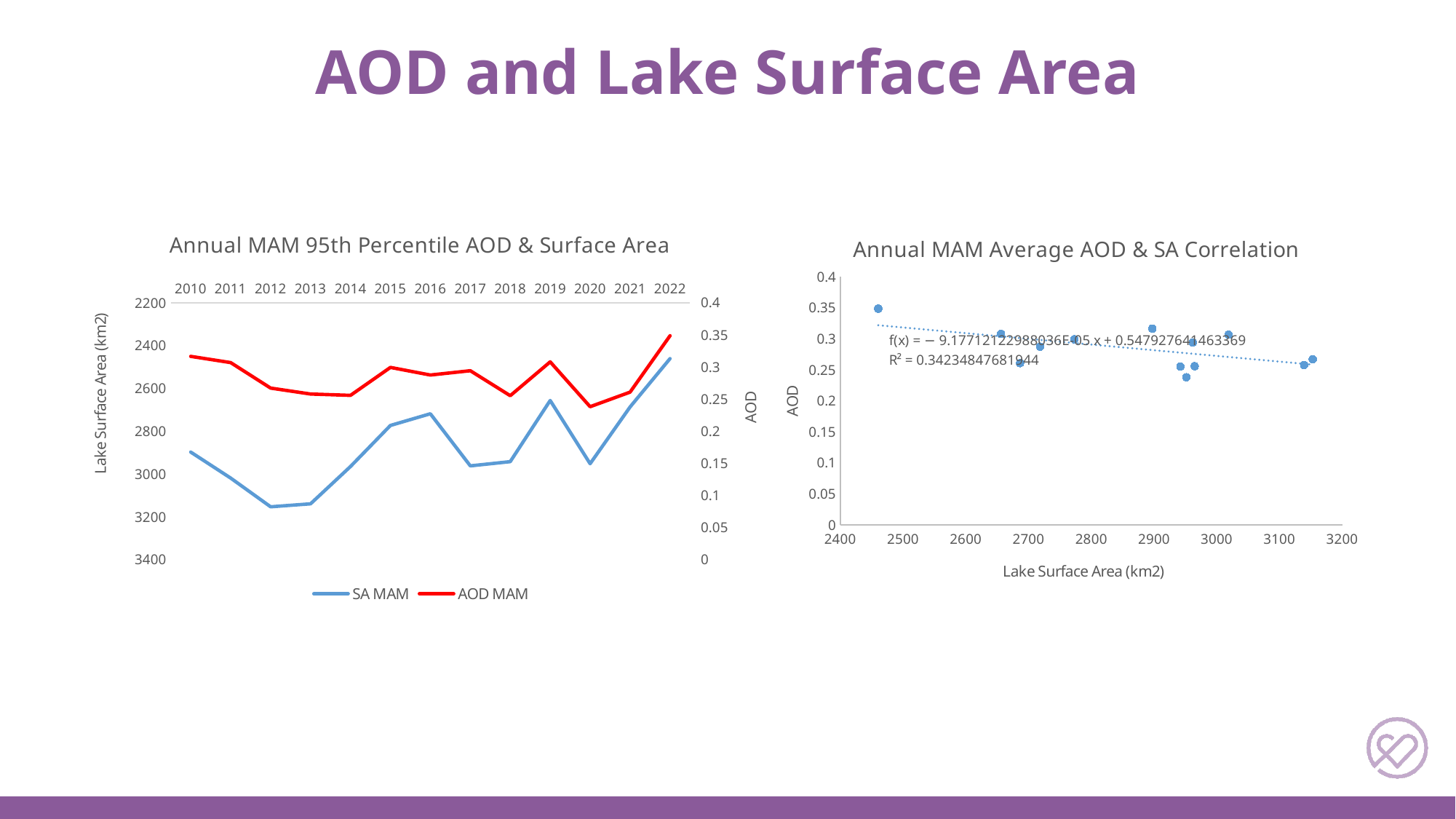
In the left chart, 'Annual MAM 95th Percentile AOD & Surface Area', which year has the larger AOD MAM value, 2010 or 2014? 2010 In the left chart, 'Annual MAM 95th Percentile AOD & Surface Area', how many years are shown on the x axis? 13 In the left chart, 'Annual MAM 95th Percentile AOD & Surface Area', which year has the highest AOD MAM value? 2022 What kind of chart is the left chart, 'Annual MAM 95th Percentile AOD & Surface Area'? line chart In the left chart, 'Annual MAM 95th Percentile AOD & Surface Area', is the SA MAM value for 2012 greater or less than 3000? greater What R² value is printed on the right chart, 'Annual MAM Average AOD & SA Correlation'? 0.3423847681944 In the left chart, 'Annual MAM 95th Percentile AOD & Surface Area', which year has the lowest AOD MAM value? 2020 In the left chart, 'Annual MAM 95th Percentile AOD & Surface Area', is the AOD MAM value for 2022 greater or less than 0.3? greater What kind of chart is the right chart, 'Annual MAM Average AOD & SA Correlation'? scatter chart In the right chart, 'Annual MAM Average AOD & SA Correlation', does the trendline rise or fall as Lake Surface Area increases? fall In the left chart, 'Annual MAM 95th Percentile AOD & Surface Area', is the AOD MAM value for 2013 greater or less than 0.3? less How many series does the legend of the left chart, 'Annual MAM 95th Percentile AOD & Surface Area', list? 2